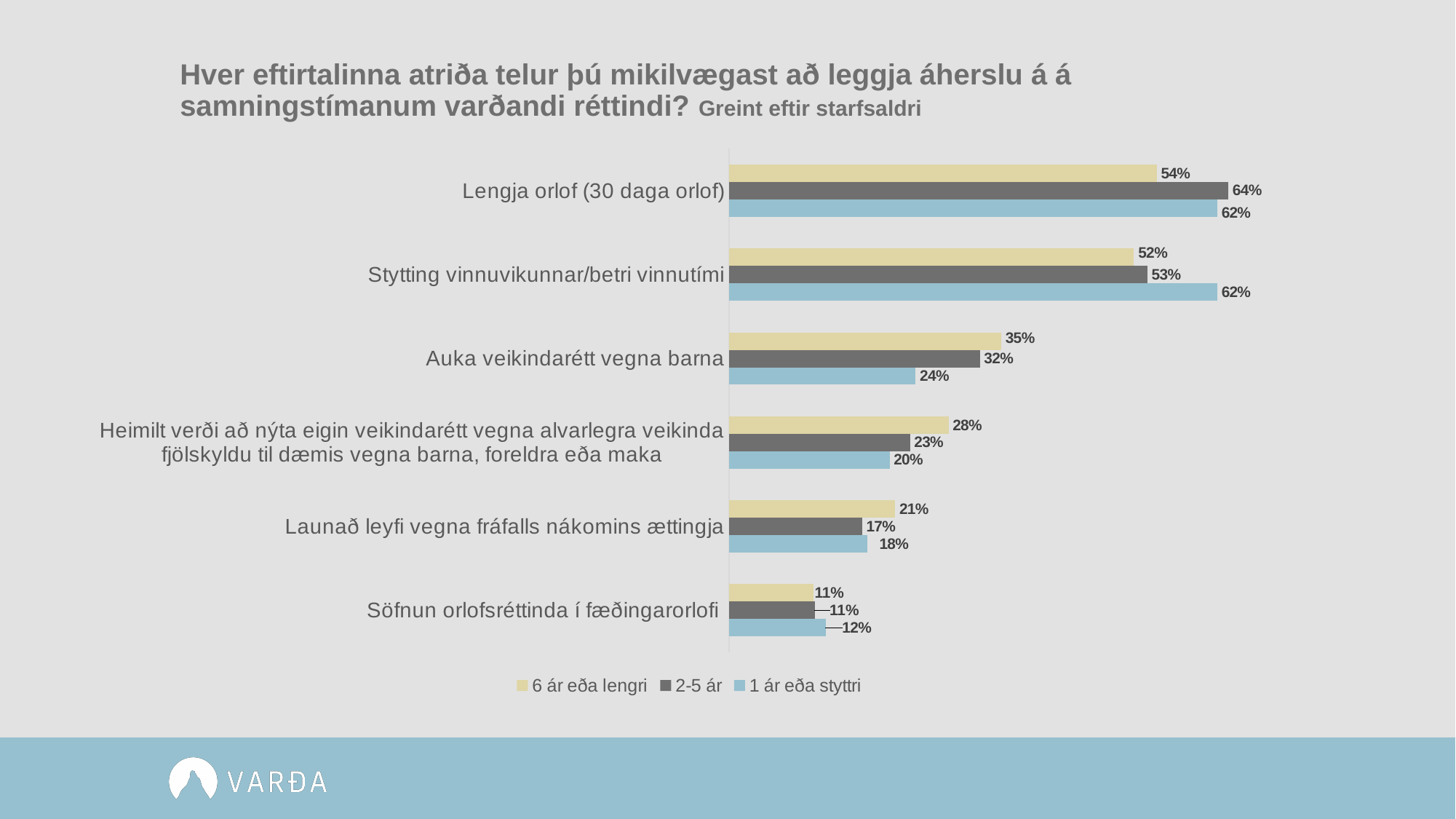
What is the value for "1 ár eða styttri" for "Stytting vinnuvikunnar/betri vinnutími"? 62% What is the value for "1 ár eða styttri" for "Launað leyfi vegna fráfalls nákomins ættingja"? 18% Which category has the lowest value for the "2-5 ár" series? Söfnun orlofsréttinda í fæðingarorlofi For "Auka veikindarétt vegna barna", which is larger: the "6 ár eða lengri" value or the "1 ár eða styttri" value? 6 ár eða lengri How many categories are shown on the chart? 6 Which series is shown in light blue in the legend? 1 ár eða styttri What kind of chart is shown on the slide? Bar chart How many series does the legend list? 3 Which category has the highest value for the "6 ár eða lengri" series? Lengja orlof (30 daga orlof) What is the value for "2-5 ár" for "Lengja orlof (30 daga orlof)"? 64% What is the difference between the "2-5 ár" and "6 ár eða lengri" values for "Lengja orlof (30 daga orlof)"? 10 percentage points What is the value for "6 ár eða lengri" for "Auka veikindarétt vegna barna"? 35%